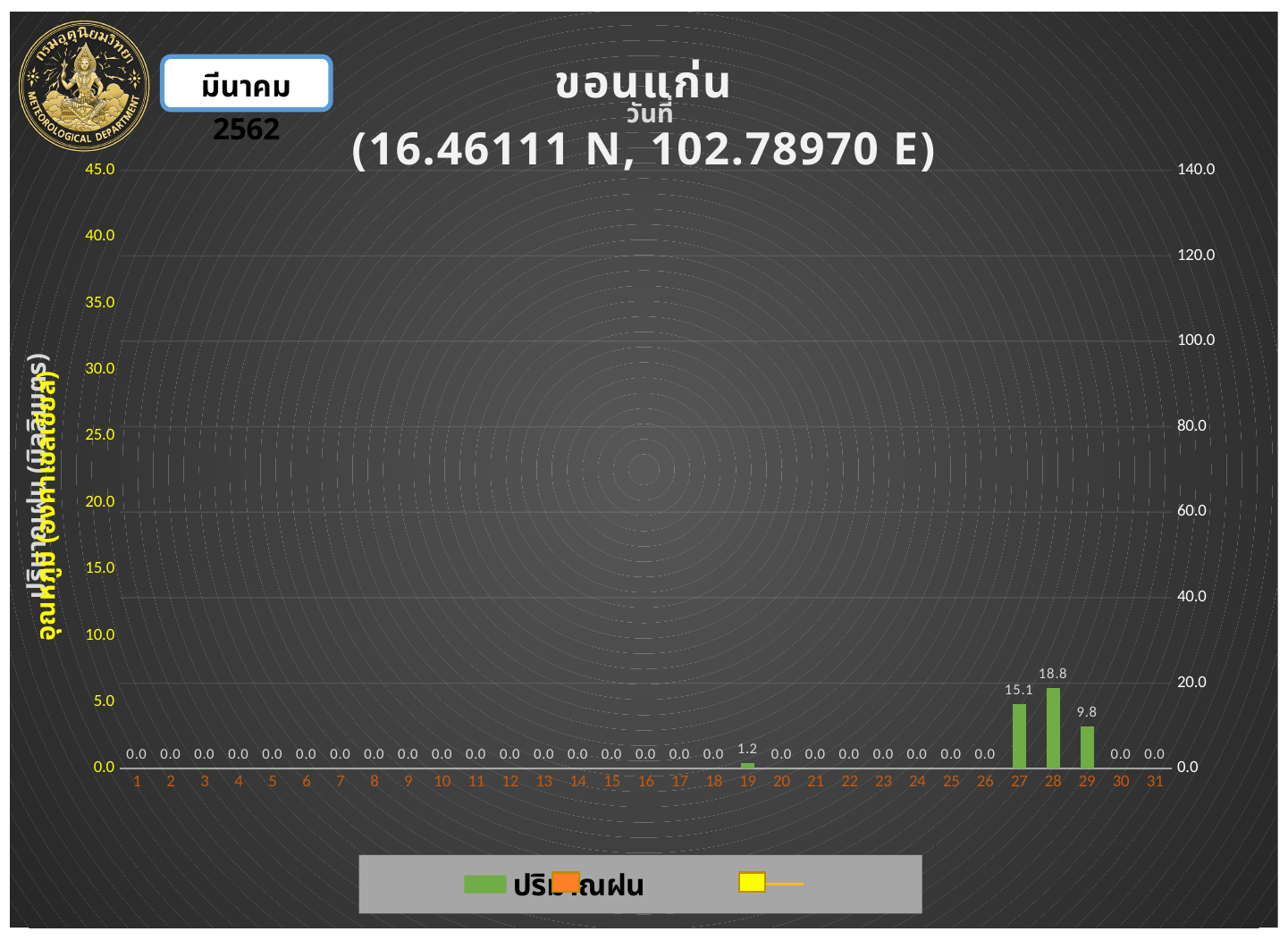
What is the rainfall value shown for day 29? 9.8 What is the difference between the rainfall values for day 28 and day 27? 3.7 Which is larger, the rainfall value for day 29 or for day 19? day 29 What is the rainfall value shown for day 19? 1.2 What is the name of the station shown in the chart title? ขอนแก่น How many days are shown on the x axis of the chart? 31 What is the difference between the rainfall values for day 27 and day 29? 5.3 What is the rainfall value shown for day 10? 0.0 What kind of chart is used to show the rainfall values? bar chart What is the rainfall value shown for day 27? 15.1 What is the rainfall value shown for day 28? 18.8 Which day has the highest rainfall value? 28